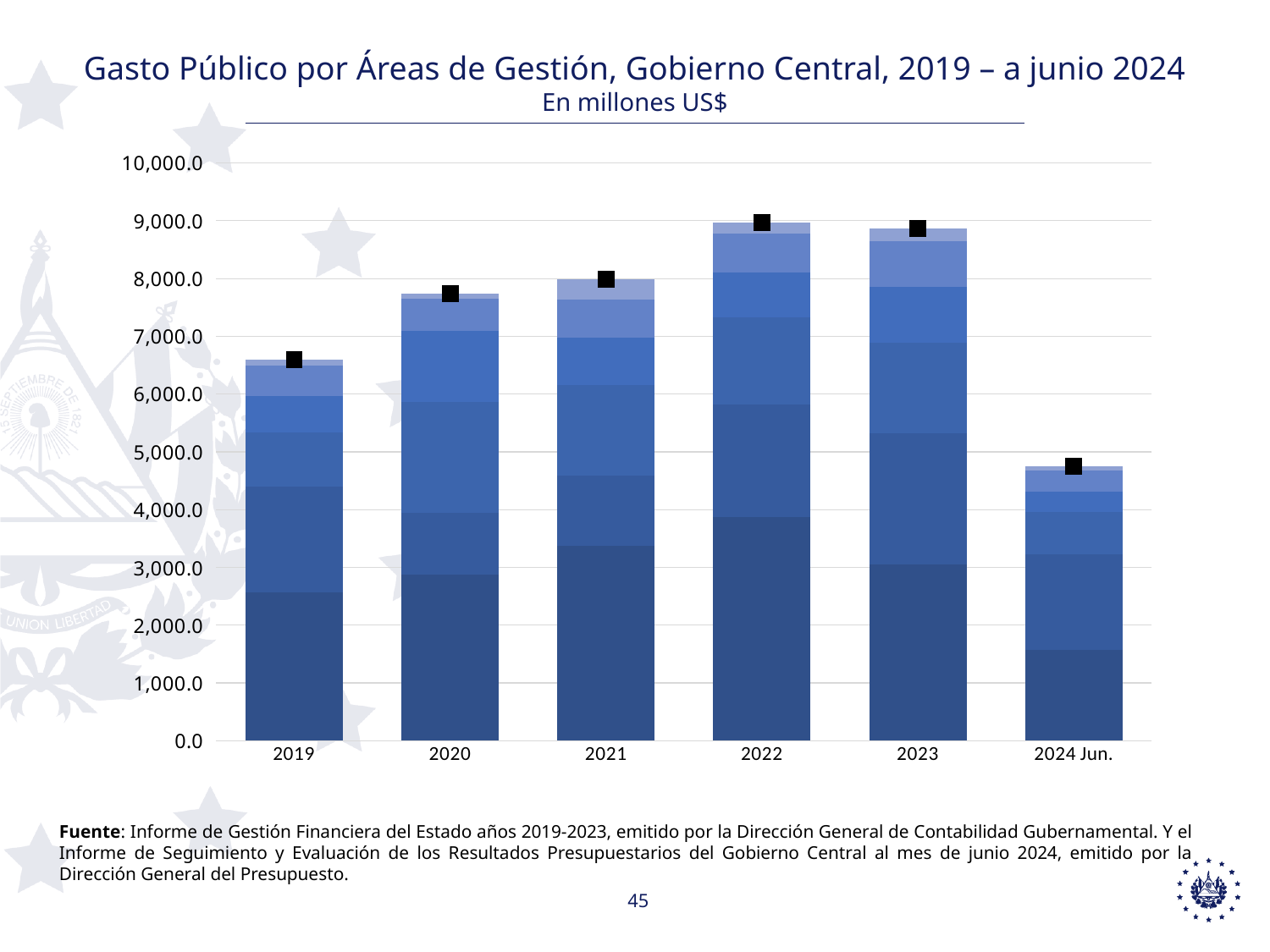
How many categories (periods) are shown on the x axis of the chart? 6 Which has a larger total, 2019 or 2020? 2020 Which has a larger total, 2021 or 2024 Jun.? 2021 Is the total for 2019 greater or less than 7,000.0? less Which period has the lowest total public spending in the chart? 2024 Jun. In what units are the values in the chart expressed, according to the subtitle? En millones US$ Is the total for 2024 Jun. greater or less than 5,000.0? less Is the total for 2020 greater or less than 7,000.0? greater Do the total bar heights rise or fall from 2019 to 2022? Rise What kind of chart is shown on the slide? Stacked bar chart